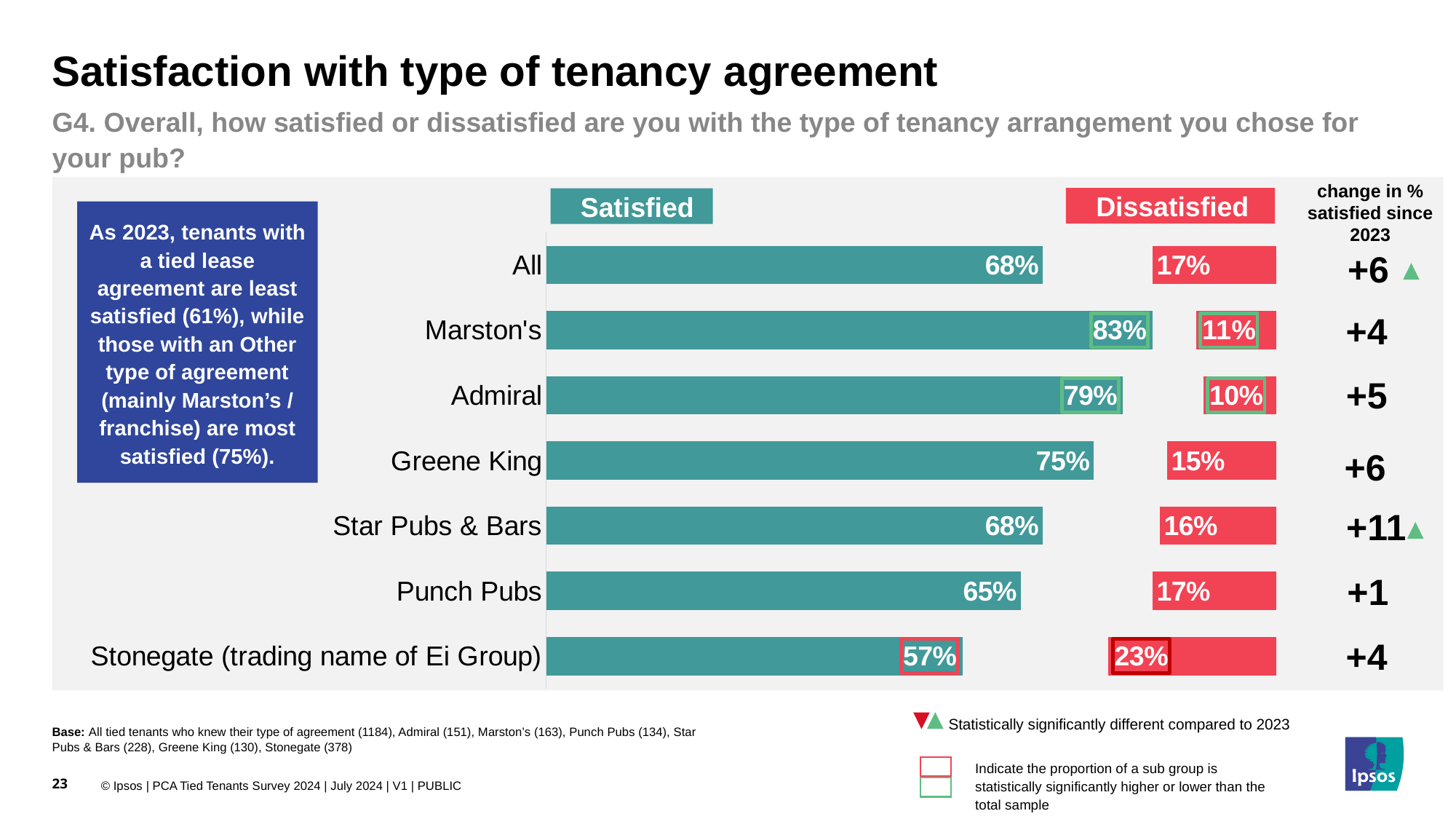
What is the difference between the Satisfied percentages for Marston's and Punch Pubs? 18 percentage points What kind of chart is shown on the slide? Bar chart What is the change in % satisfied since 2023 for Star Pubs & Bars? +11 Which pub company has the highest Satisfied percentage? Marston's Which category has the lowest Dissatisfied percentage? Admiral What is the Satisfied value for Greene King? 75% Which has a higher Dissatisfied percentage, Star Pubs & Bars or Punch Pubs? Punch Pubs What percentage of Marston's tenants are satisfied with their type of tenancy agreement? 83% Which category has the lowest Satisfied percentage? Stonegate (trading name of Ei Group) How many categories are shown on the chart? 7 How many series does the chart show? 2 What is the Dissatisfied value for Stonegate (trading name of Ei Group)? 23%